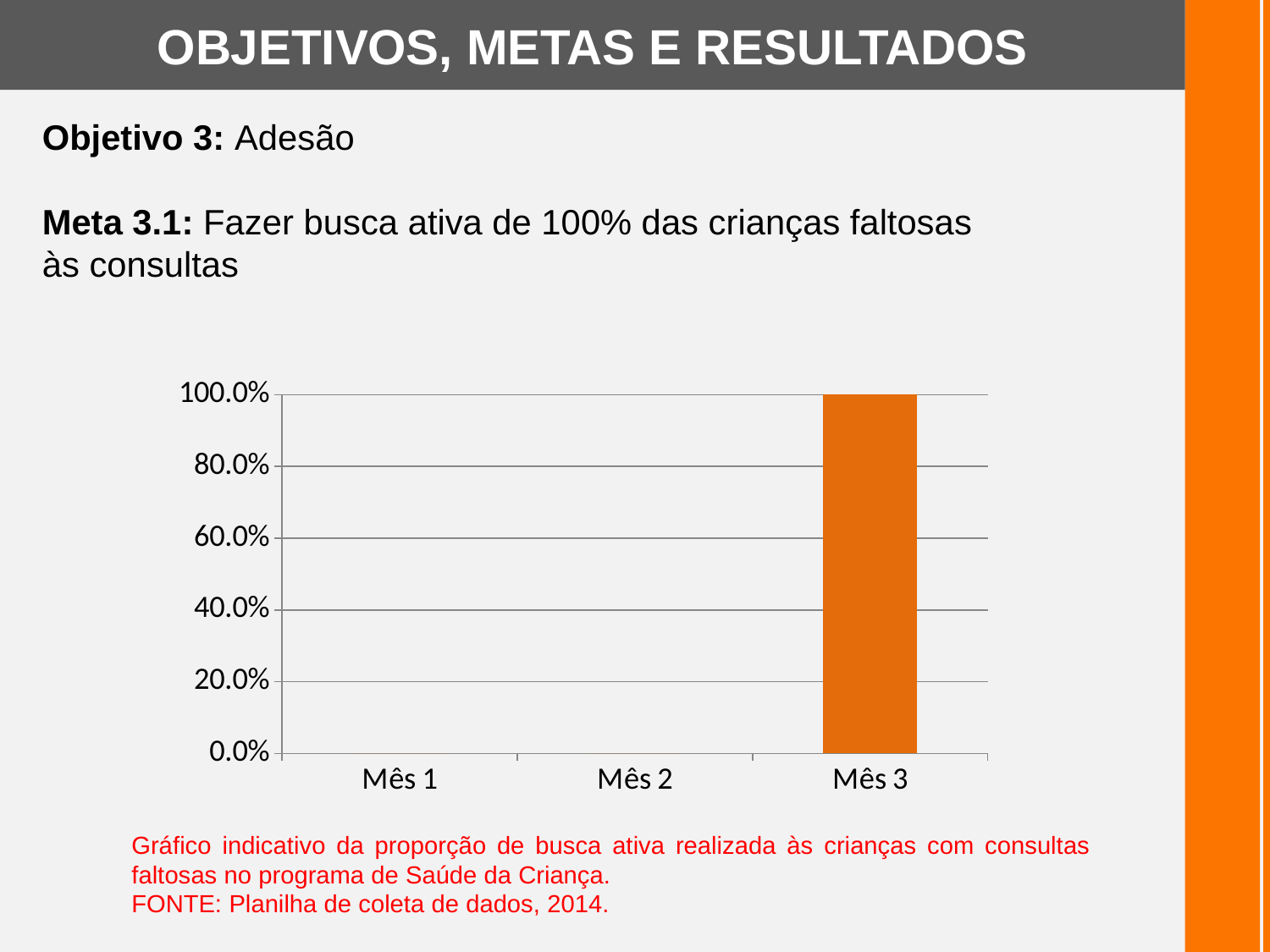
Do the values in the chart rise or fall from Mês 1 to Mês 3? rise Is the value for Mês 1 greater or less than 20.0%? less How many categories are shown on the x axis of the chart? 3 Is the value for Mês 2 greater or less than 20.0%? less Is the value for Mês 3 greater or less than 80.0%? greater Which category has the highest value in the chart? Mês 3 Which is larger, the value for Mês 2 or the value for Mês 3? Mês 3 What is the value for Mês 3 in the chart? 100.0% What colour is the bar for Mês 3 in the chart? orange What kind of chart is shown on the slide? bar chart What is the highest value shown on the y axis of the chart? 100.0%